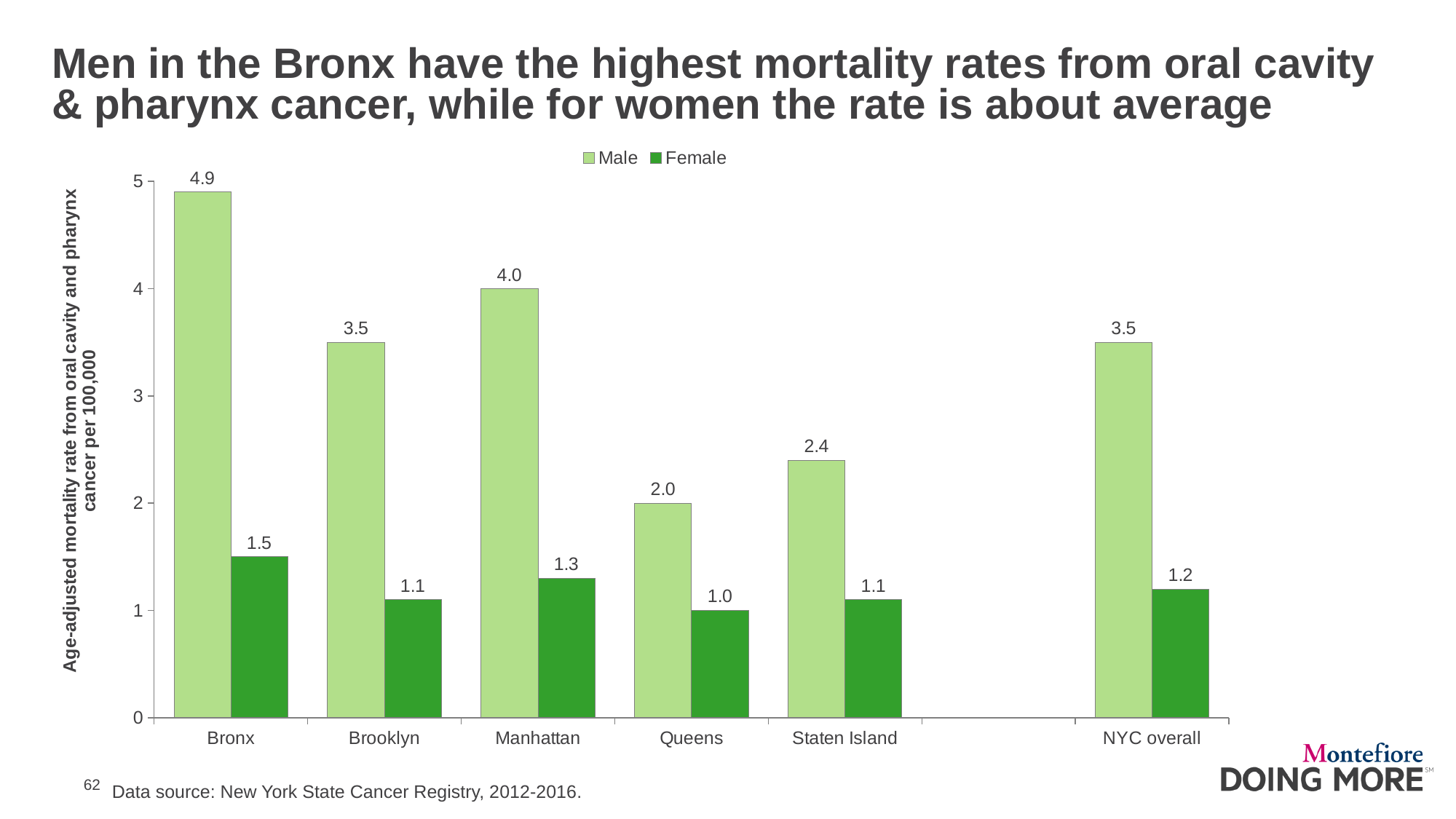
Which borough has the lowest Female mortality rate? Queens How many series does the legend list? 2 What is the difference between the Male and Female mortality rates in the Bronx? 3.4 What kind of chart is shown on the slide? Bar chart Which is larger, the Male mortality rate for Brooklyn or for Staten Island? Brooklyn Is the Male mortality rate for Staten Island greater or less than 3? less How many categories are shown on the x axis? 6 What is the Female mortality rate for Manhattan? 1.3 What is the difference between the Male mortality rates for Manhattan and Queens? 2.0 Which borough has the highest Male mortality rate? Bronx What is the Female mortality rate for NYC overall? 1.2 What is the Male mortality rate for the Bronx? 4.9